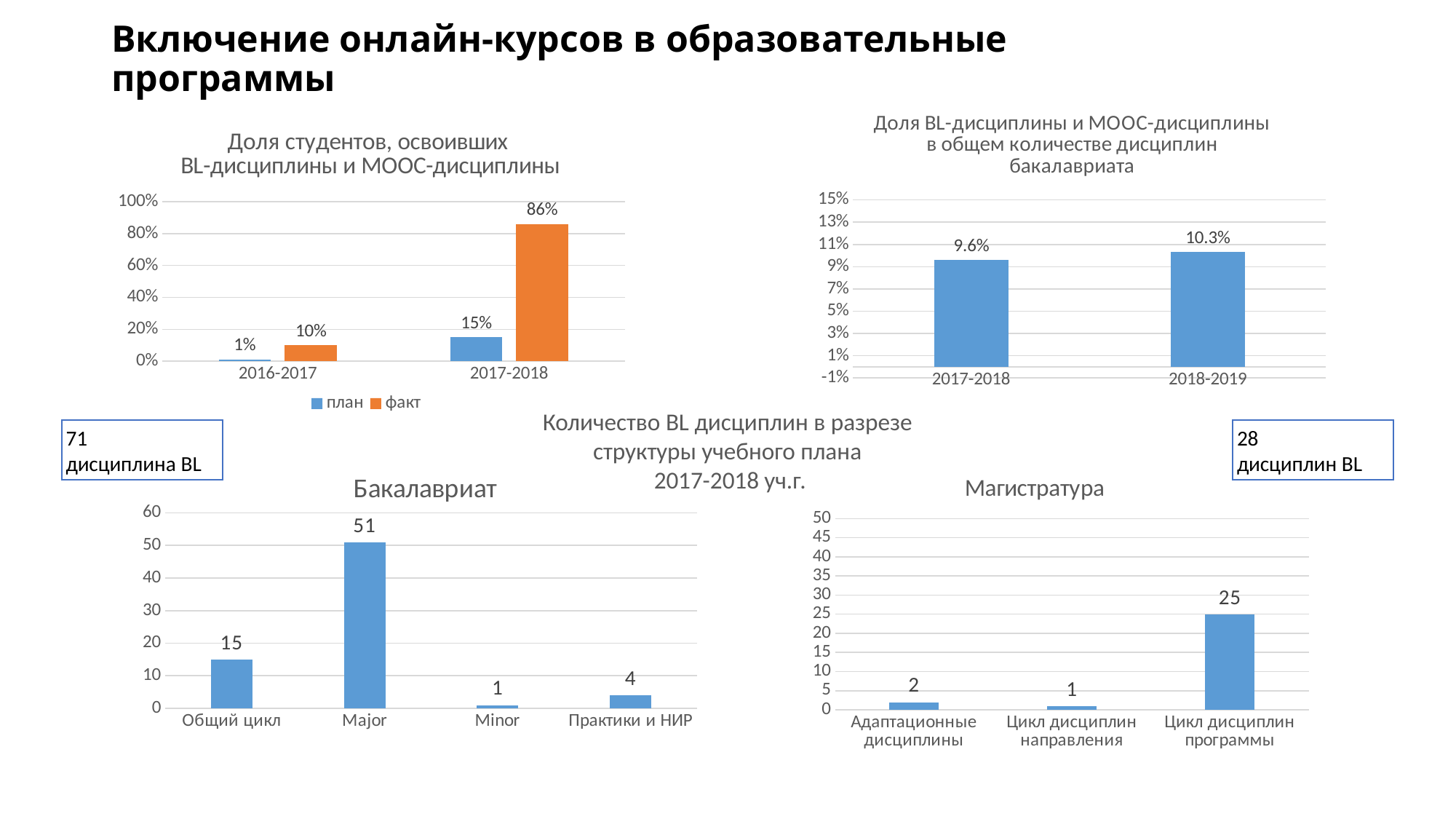
In the 'Бакалавриат' chart, which category has the lowest value? Minor In the chart 'Доля BL-дисциплины и MOOC-дисциплины в общем количестве дисциплин бакалавриата', what is the value for 2018-2019? 10.3% In the 'Бакалавриат' chart, what is the value for 'Общий цикл'? 15 In the chart 'Доля студентов, освоивших BL-дисциплины и MOOC-дисциплины', what is the 'план' value for 2016-2017? 1% In the chart 'Доля BL-дисциплины и MOOC-дисциплины в общем количестве дисциплин бакалавриата', do the values rise or fall from 2017-2018 to 2018-2019? rise In the 'Магистратура' chart, what is the value for 'Цикл дисциплин программы'? 25 In the chart 'Доля студентов, освоивших BL-дисциплины и MOOC-дисциплины', what is the difference between 'факт' and 'план' for 2017-2018? 71% How many series does the legend of the chart 'Доля студентов, освоивших BL-дисциплины и MOOC-дисциплины' list? 2 What type of chart is the 'Магистратура' chart? bar chart In the 'Бакалавриат' chart, which category has the highest value? Major In the chart 'Доля студентов, освоивших BL-дисциплины и MOOC-дисциплины', what is the 'факт' value for 2017-2018? 86% How many categories are shown in the 'Магистратура' chart? 3